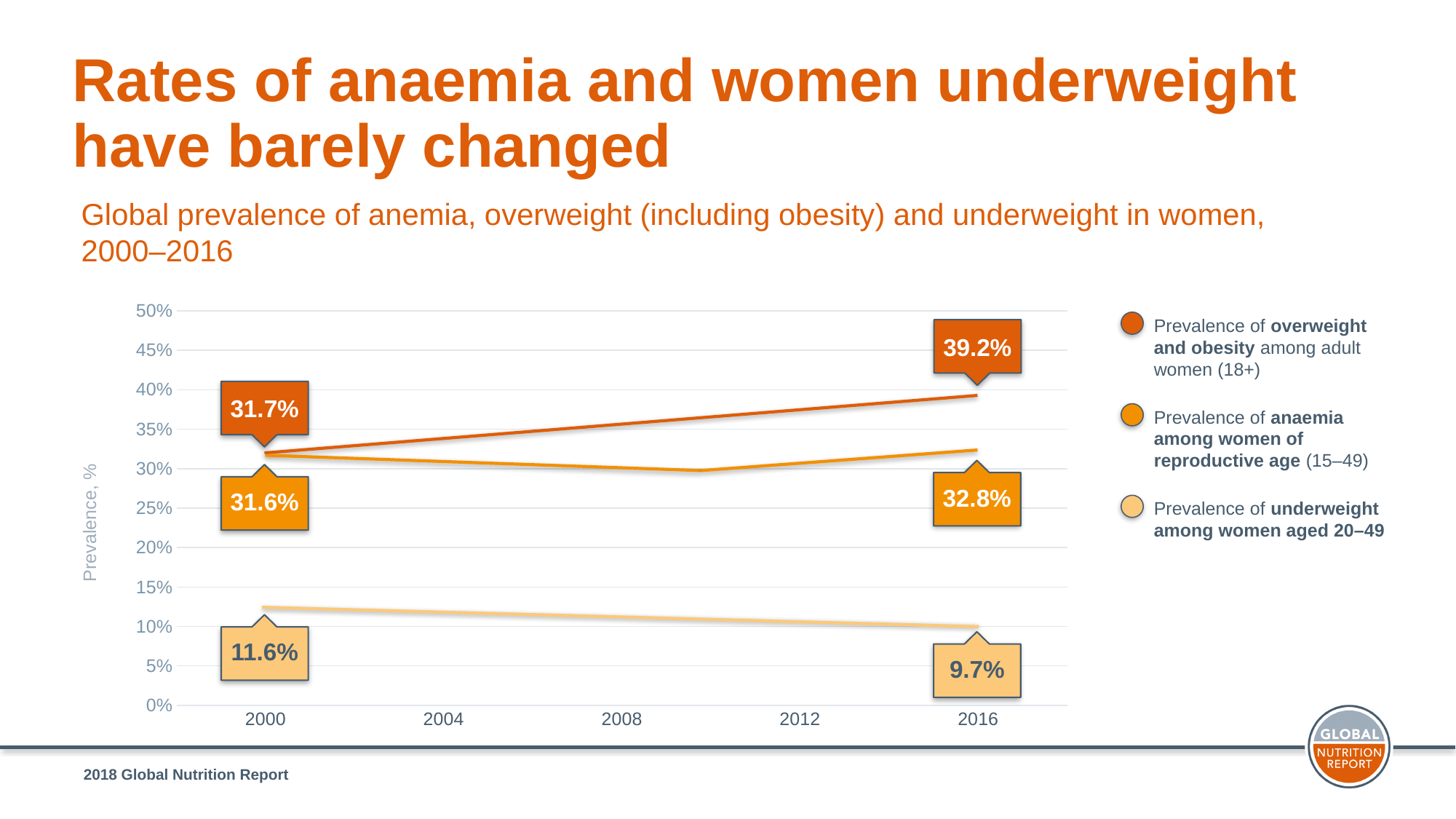
What was the prevalence of overweight and obesity among adult women in 2000? 31.7% How many series does the legend list? 3 What was the prevalence of underweight among women aged 20–49 in 2016? 9.7% Is the 2016 value for anaemia among women of reproductive age greater or less than 30%? greater Which series had the lowest value in 2000? Prevalence of underweight among women aged 20–49 Which series had the highest value in 2016? Prevalence of overweight and obesity among adult women (18+) What was the prevalence of overweight and obesity among adult women in 2016? 39.2% What was the prevalence of anaemia among women of reproductive age in 2000? 31.6% Did the prevalence of underweight among women aged 20–49 rise or fall from 2000 to 2016? fall By how many percentage points did the prevalence of underweight fall between 2000 and 2016? 1.9 percentage points By how many percentage points did the prevalence of overweight and obesity change between 2000 and 2016? 7.5 percentage points What kind of chart is shown on the slide? line chart